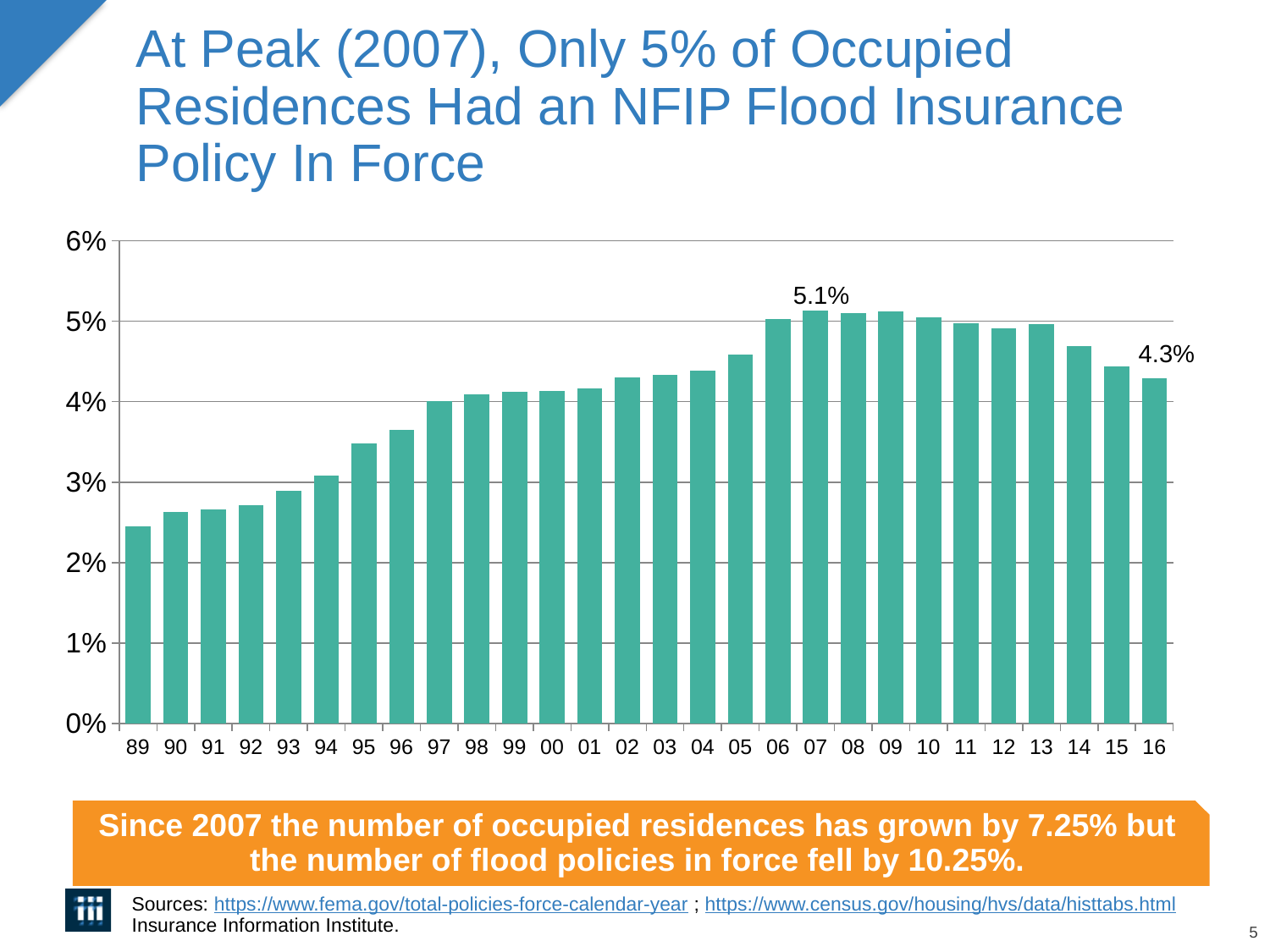
Is the value for 92 greater or less than 3%? less Which is larger, the value for 07 or the value for 16? 07 What is the value shown for 07? 5.1% Which is larger, the value for 89 or the value for 16? 16 Is the value for 95 greater or less than 4%? less Do the values rise or fall from 07 to 16? Fall What is the value shown for 16? 4.3% What kind of chart is shown on the slide? Bar chart Is the value for 14 greater or less than 4%? greater Which year has the lowest bar? 89 How many years are shown on the x axis? 28 What is the difference between the labeled values for 07 and 16? 0.8 percentage points